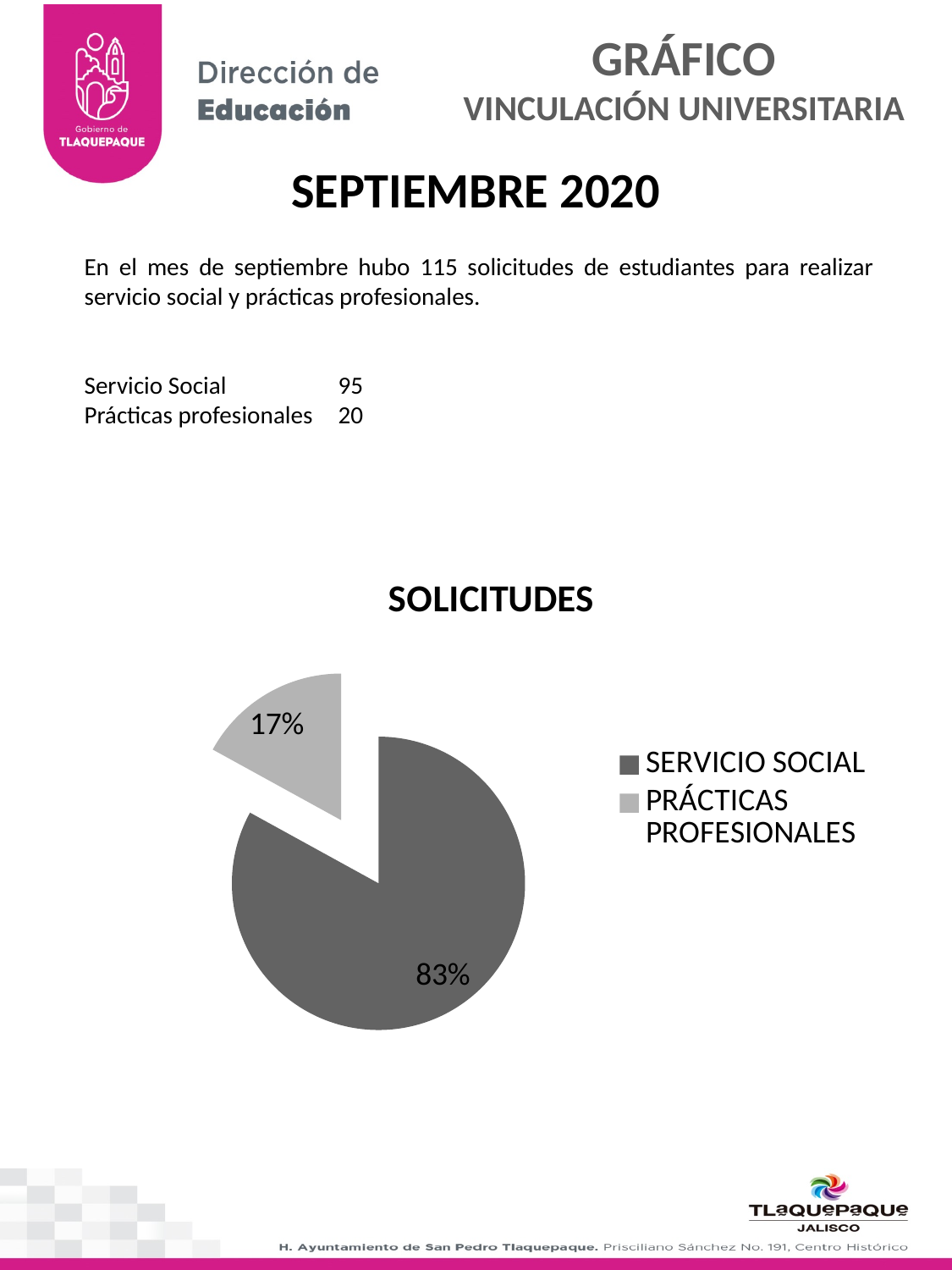
Which is larger in the pie chart, SERVICIO SOCIAL or PRÁCTICAS PROFESIONALES? SERVICIO SOCIAL How many slices does the pie chart have? 2 How many entries does the legend of the pie chart list? 2 Is the share for PRÁCTICAS PROFESIONALES greater or less than 20%? less Which legend entry is shown in the lighter grey colour? PRÁCTICAS PROFESIONALES What is the difference in percentage points between the SERVICIO SOCIAL slice and the PRÁCTICAS PROFESIONALES slice? 66% What share of the pie does PRÁCTICAS PROFESIONALES represent? 17% What is the title of the pie chart? SOLICITUDES Which slice of the pie is the largest? SERVICIO SOCIAL What kind of chart is shown under the title SOLICITUDES? pie chart Which slice of the pie is the smallest? PRÁCTICAS PROFESIONALES What share of the pie does SERVICIO SOCIAL represent? 83%